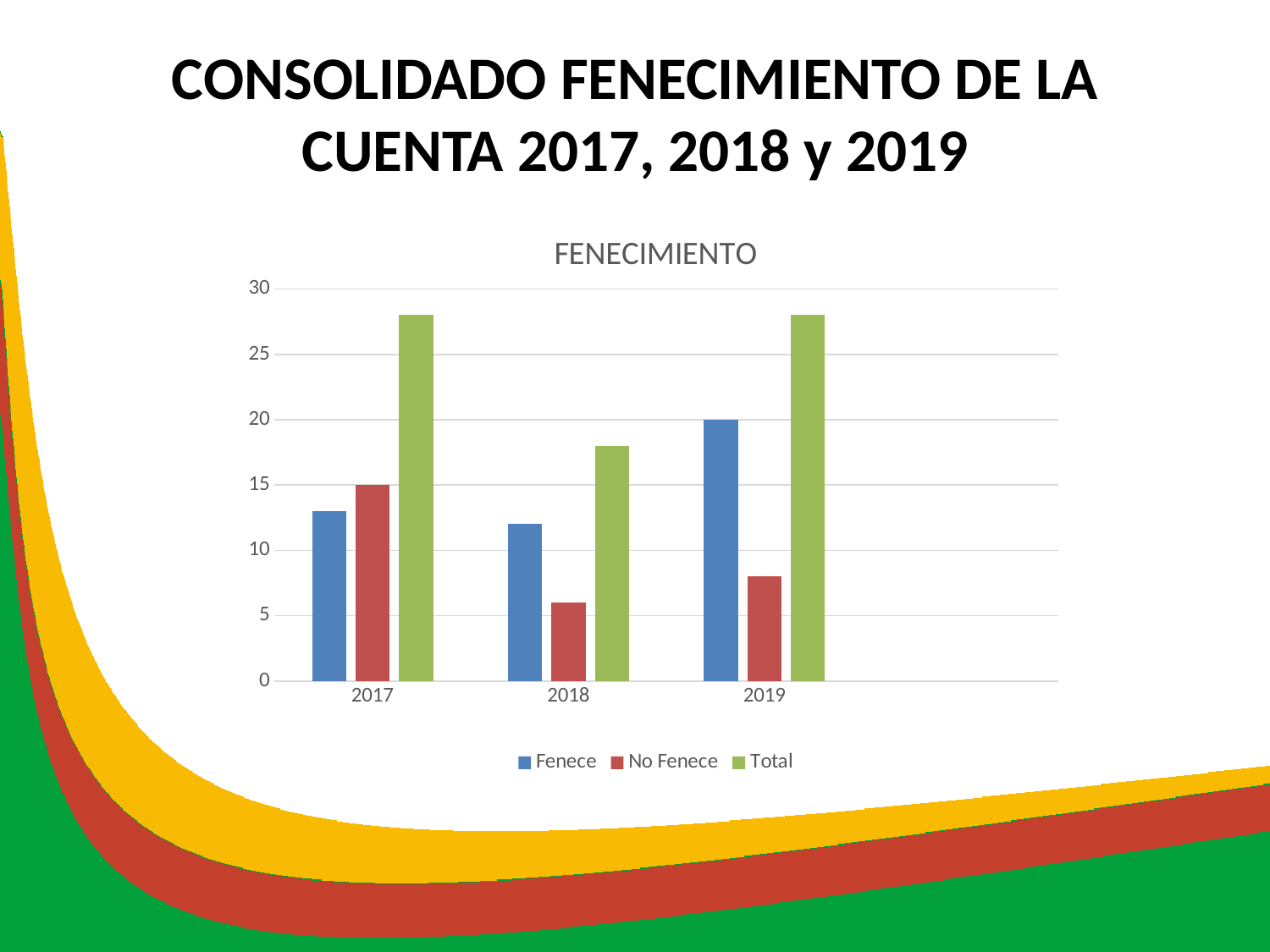
What is the value of Fenece for 2019? 20 Is the No Fenece value for 2018 greater or less than 10? less Which year has the highest Fenece value? 2019 What kind of chart is shown on the slide? bar chart Which is larger for 2017, Fenece or No Fenece? No Fenece Is the Total value for 2018 greater or less than 15? greater Is the Total value for 2017 greater or less than 25? greater Which year has the lowest Total value? 2018 How many series does the legend list? 3 What is the title of the chart? FENECIMIENTO How many years are shown on the x axis? 3 What is the value of No Fenece for 2017? 15